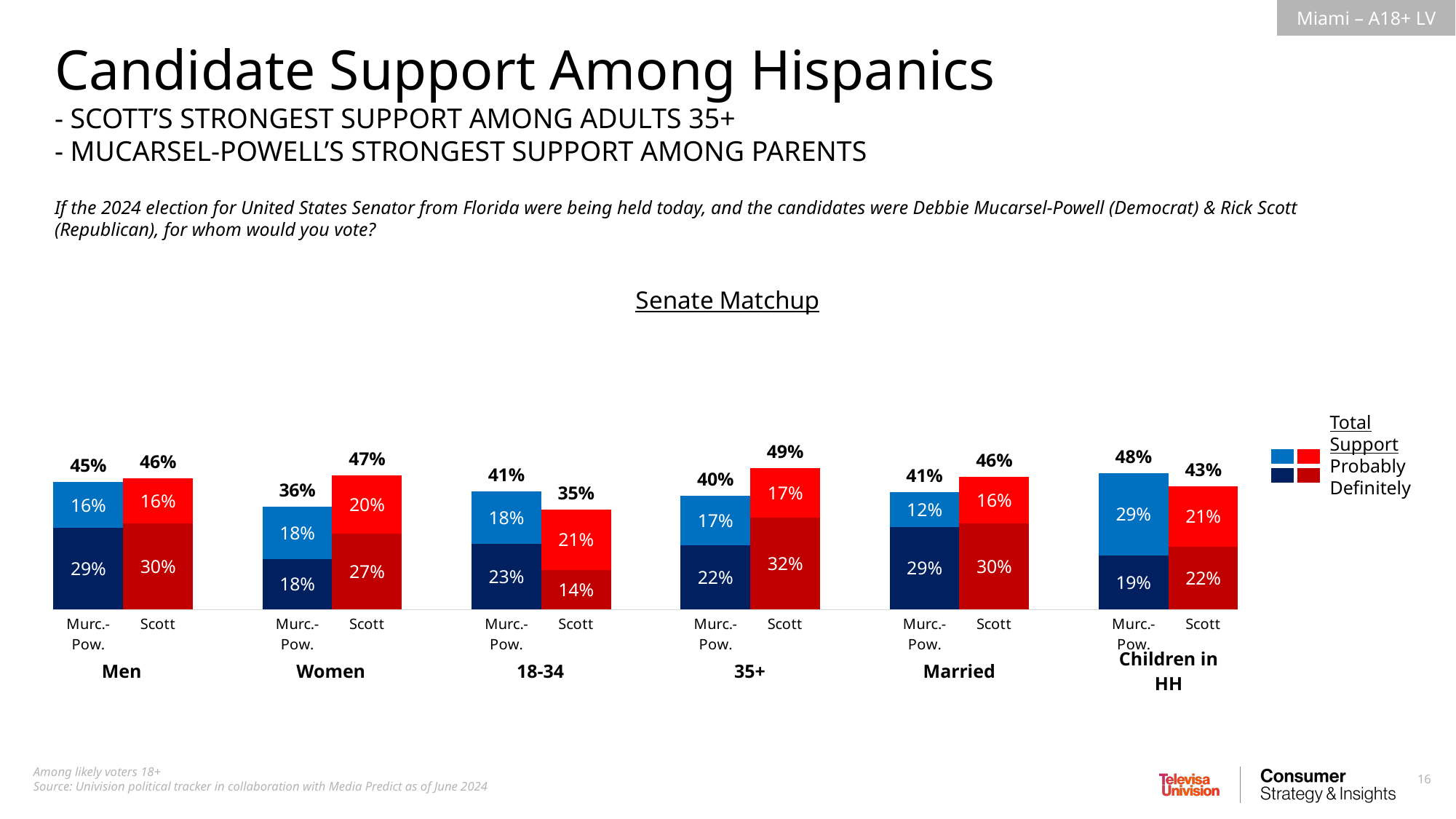
What is the total support for Mucarsel-Powell among voters with children in the household? 48% How many demographic groups are shown in the Senate Matchup chart? 6 What two levels of support does the legend distinguish? Probably and Definitely What kind of chart is the Senate Matchup chart? Stacked bar chart In which demographic group does Scott have his highest total support? 35+ Among voters aged 18-34, who has higher total support, Mucarsel-Powell or Scott? Mucarsel-Powell What is the difference between Scott's and Mucarsel-Powell's total support among women? 11 percentage points What is the 'Probably' support for Mucarsel-Powell among married voters? 12% What is the total support for Scott among adults 35+? 49% What is the total of the stacked bar for Mucarsel-Powell among men? 45% What is the 'Definitely' support for Scott among women? 27% In which demographic group does Scott have his lowest total support? 18-34